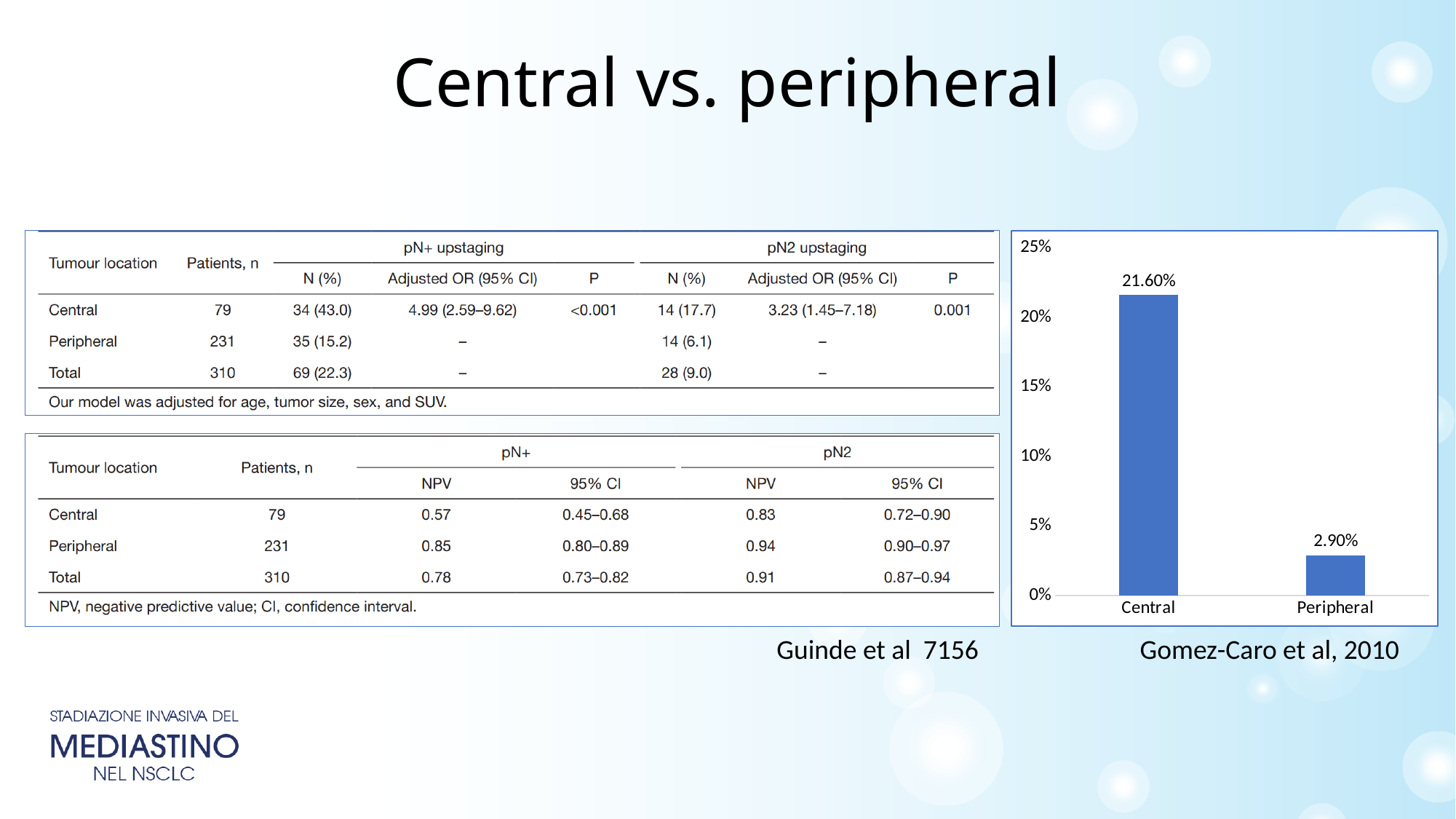
Is the value for Central in the bar chart greater or less than 20%? greater What is the difference between the Central and Peripheral values in the bar chart? 18.70% What is the value for Central in the bar chart? 21.60% Is the value for Peripheral in the bar chart greater or less than 5%? less What is the value for Peripheral in the bar chart? 2.90% Which source is cited below the bar chart? Gomez-Caro et al, 2010 How many categories are shown in the bar chart? 2 What kind of chart is shown on the right of the slide? bar chart What is the maximum value shown on the y axis of the bar chart? 25% In the bar chart, is the value for Central or Peripheral larger? Central Which category has the lowest value in the bar chart? Peripheral Which category has the highest value in the bar chart? Central